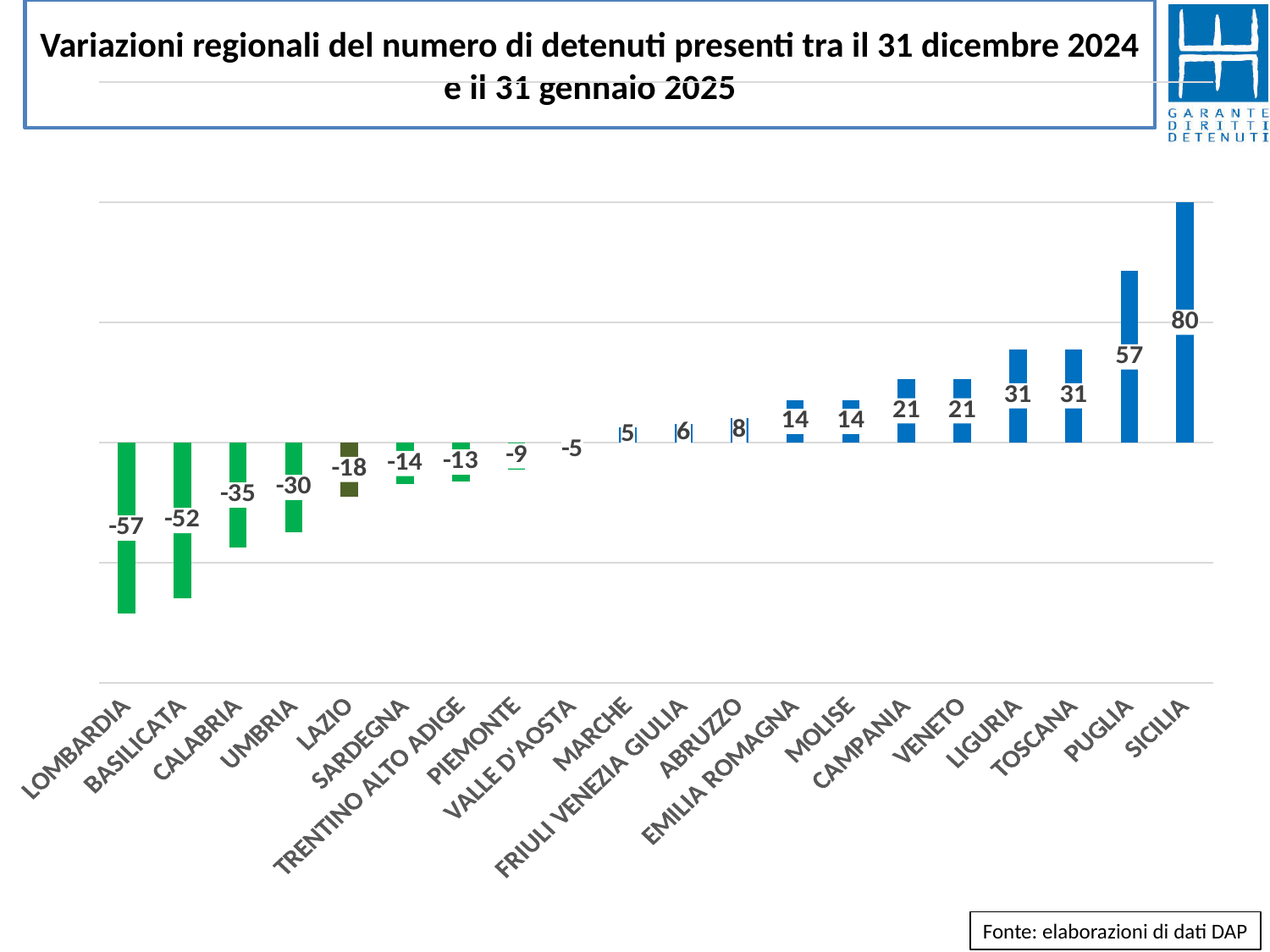
What is the difference between the values for Sicilia and Puglia? 23 Which region has the highest value? Sicilia Which region has the lowest value? Lombardia Do the values rise or fall from left to right along the x axis? Rise What is the value for Campania? 21 What is the value for Sicilia? 80 How many regions are shown on the chart? 20 Which has a larger value, Liguria or Veneto? Liguria What kind of chart is this? Bar chart What is the difference between the values for Calabria and Umbria? 5 What is the value for Lombardia? -57 What is the value for Lazio? -18